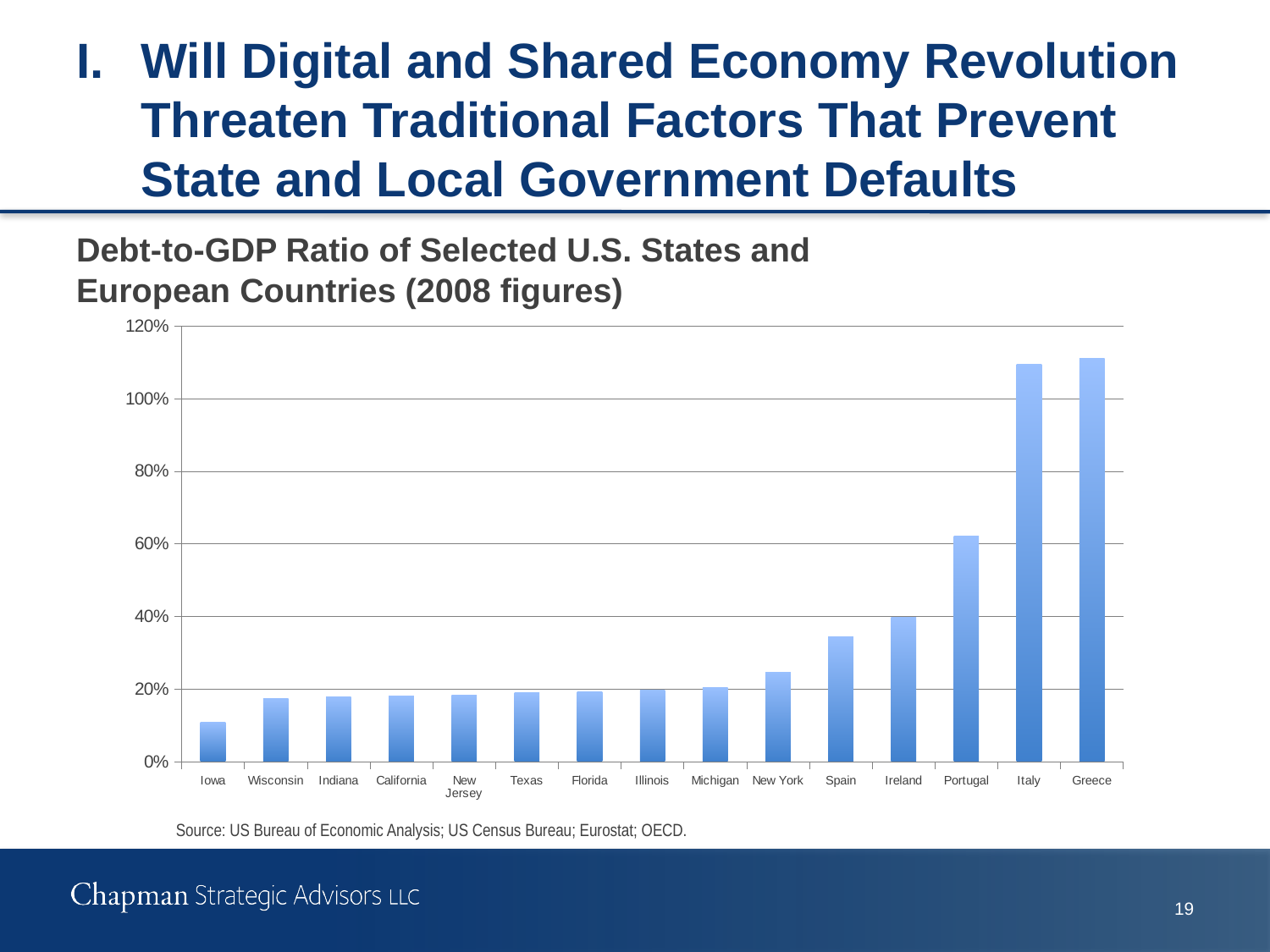
Which has a higher debt-to-GDP ratio, Portugal or Ireland? Portugal What year do the figures in the chart refer to, according to the chart title? 2008 Do the debt-to-GDP ratios generally rise or fall moving from left to right along the x axis? Rise Which has a higher debt-to-GDP ratio, California or Spain? Spain How many states and countries are shown on the x axis of the chart? 15 Is the debt-to-GDP ratio for Italy greater or less than 100%? greater Is the debt-to-GDP ratio for Portugal greater or less than 80%? less Is the debt-to-GDP ratio for Iowa greater or less than 20%? less What kind of chart is shown on the slide? Bar chart Which state or country has the lowest debt-to-GDP ratio in the chart? Iowa